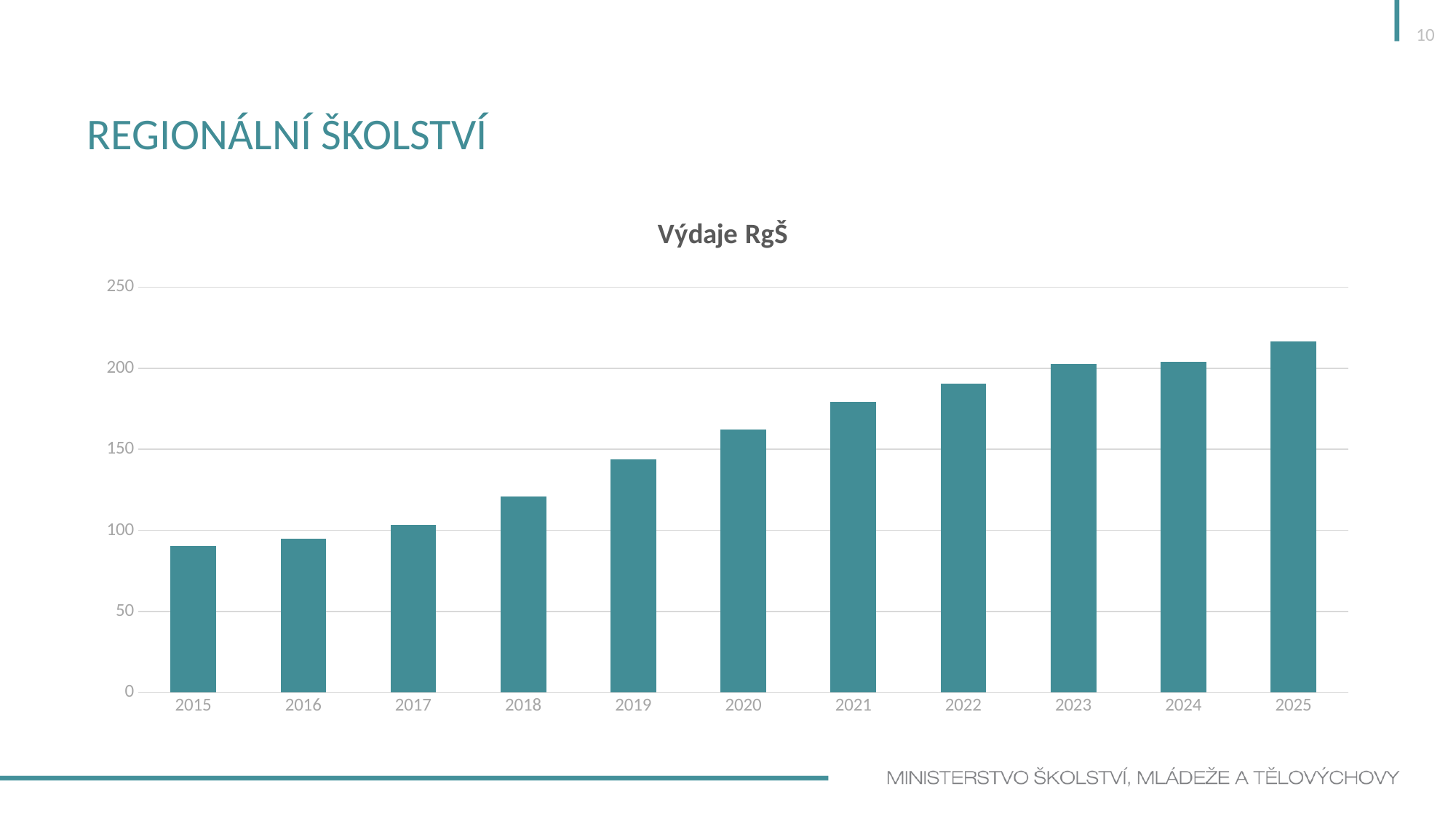
Is the value for 2018 greater or less than 100? greater Is the value for 2015 greater or less than 100? less Is the value for 2022 greater or less than 200? less Do the values generally rise or fall from 2015 to 2025? rise Which year has the larger value, 2017 or 2020? 2020 Which year has the lowest value in the chart? 2015 How many years are shown on the x axis of the chart? 11 What kind of chart is shown on the slide? bar chart What is the title of the chart? Výdaje RgŠ Which year has the highest value in the chart? 2025